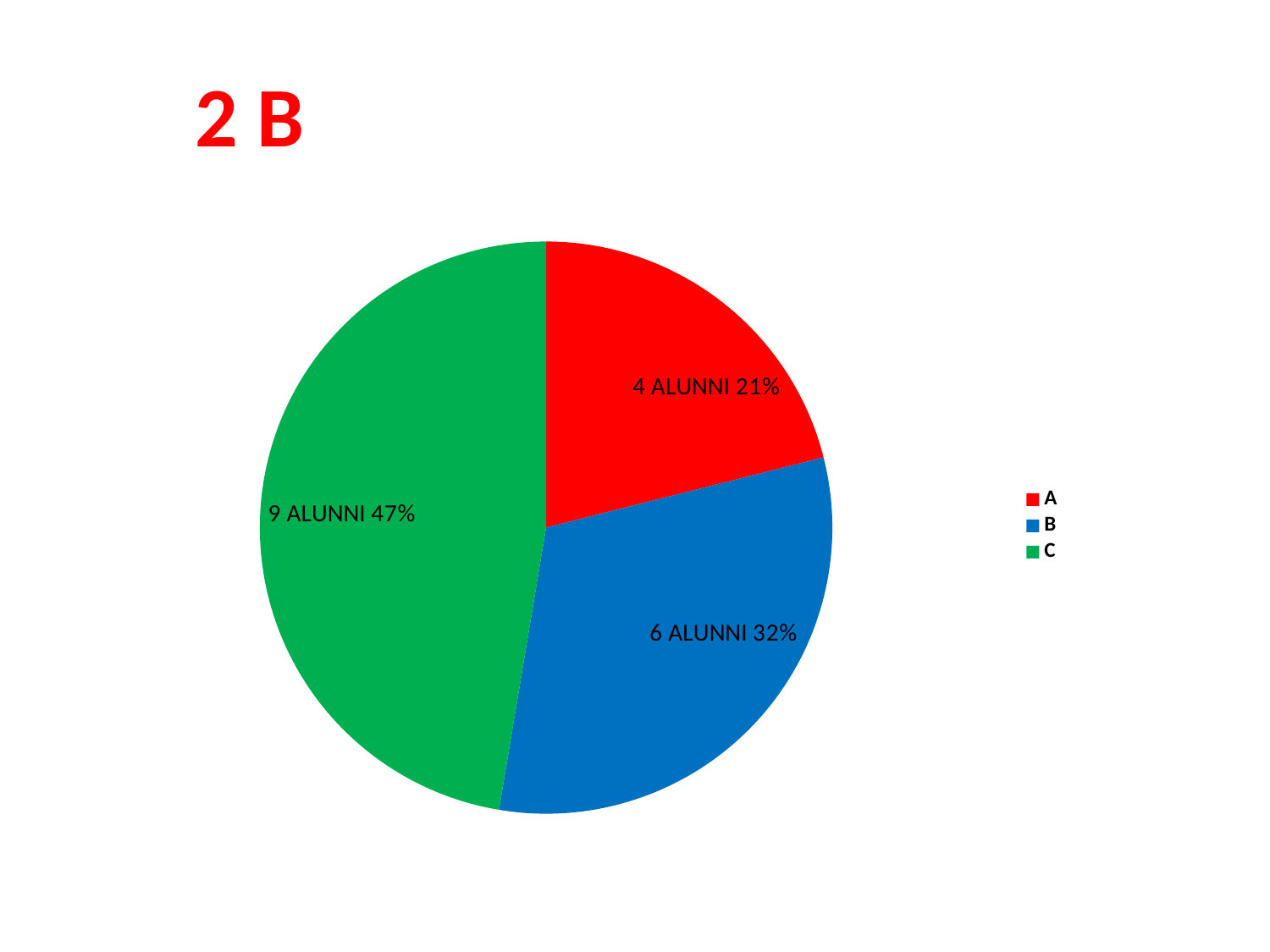
What is the data label for slice C? 9 ALUNNI 47% What is the data label for slice A? 4 ALUNNI 21% How many slices does the pie chart have? 3 Which slice is the smallest? A Which slice is the largest? C What colour is slice B in the pie chart? blue Which slice is larger, A or B? B What is the data label for slice B? 6 ALUNNI 32% How many entries does the legend list? 3 How many more alunni are in slice C than in slice A? 5 What share of the pie does slice C represent? 47% What kind of chart is shown on the slide? pie chart